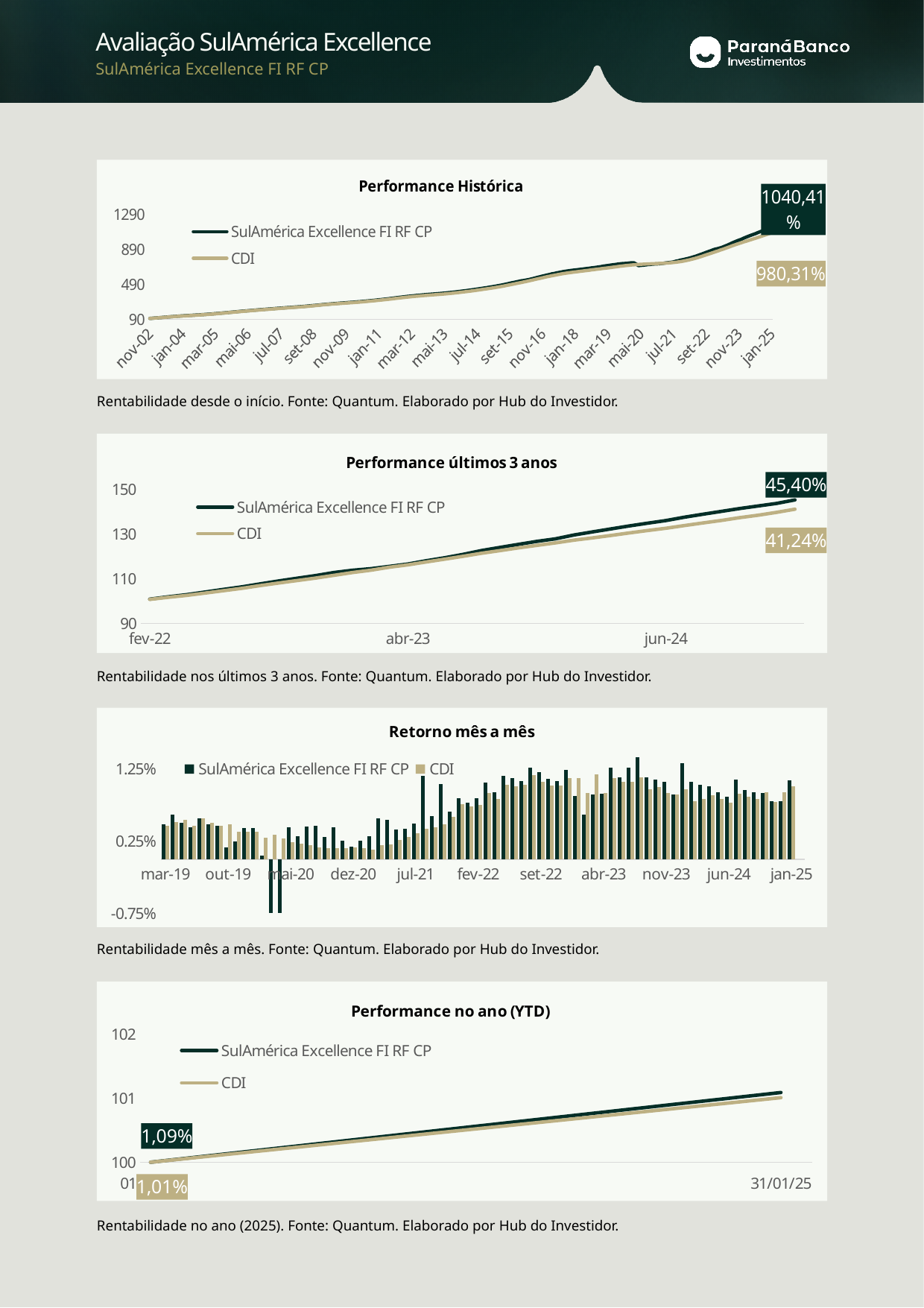
What kind of chart is 'Retorno mês a mês'? bar chart In the 'Performance últimos 3 anos' chart, which series ends higher, SulAmérica Excellence FI RF CP or CDI? SulAmérica Excellence FI RF CP In the 'Performance últimos 3 anos' chart, what is the final value shown for CDI? 41,24% In the 'Performance últimos 3 anos' chart, what is the difference between the final values of SulAmérica Excellence FI RF CP and CDI? 4,16% In the 'Performance Histórica' chart, what is the final value shown for SulAmérica Excellence FI RF CP? 1040,41% In the 'Performance últimos 3 anos' chart, do the lines rise or fall from fev-22 to the end? rise In the 'Performance Histórica' chart, what is the final value shown for CDI? 980,31% In the 'Performance Histórica' chart, what is the difference between the final values of SulAmérica Excellence FI RF CP and CDI? 60,10% How many series does the legend of the 'Retorno mês a mês' chart list? 2 In the 'Performance no ano (YTD)' chart, what is the value shown for SulAmérica Excellence FI RF CP? 1,09% In the 'Performance no ano (YTD)' chart, what is the value shown for CDI? 1,01% In the 'Performance Histórica' chart, is the SulAmérica Excellence FI RF CP value at jan-18 greater or less than 490? greater